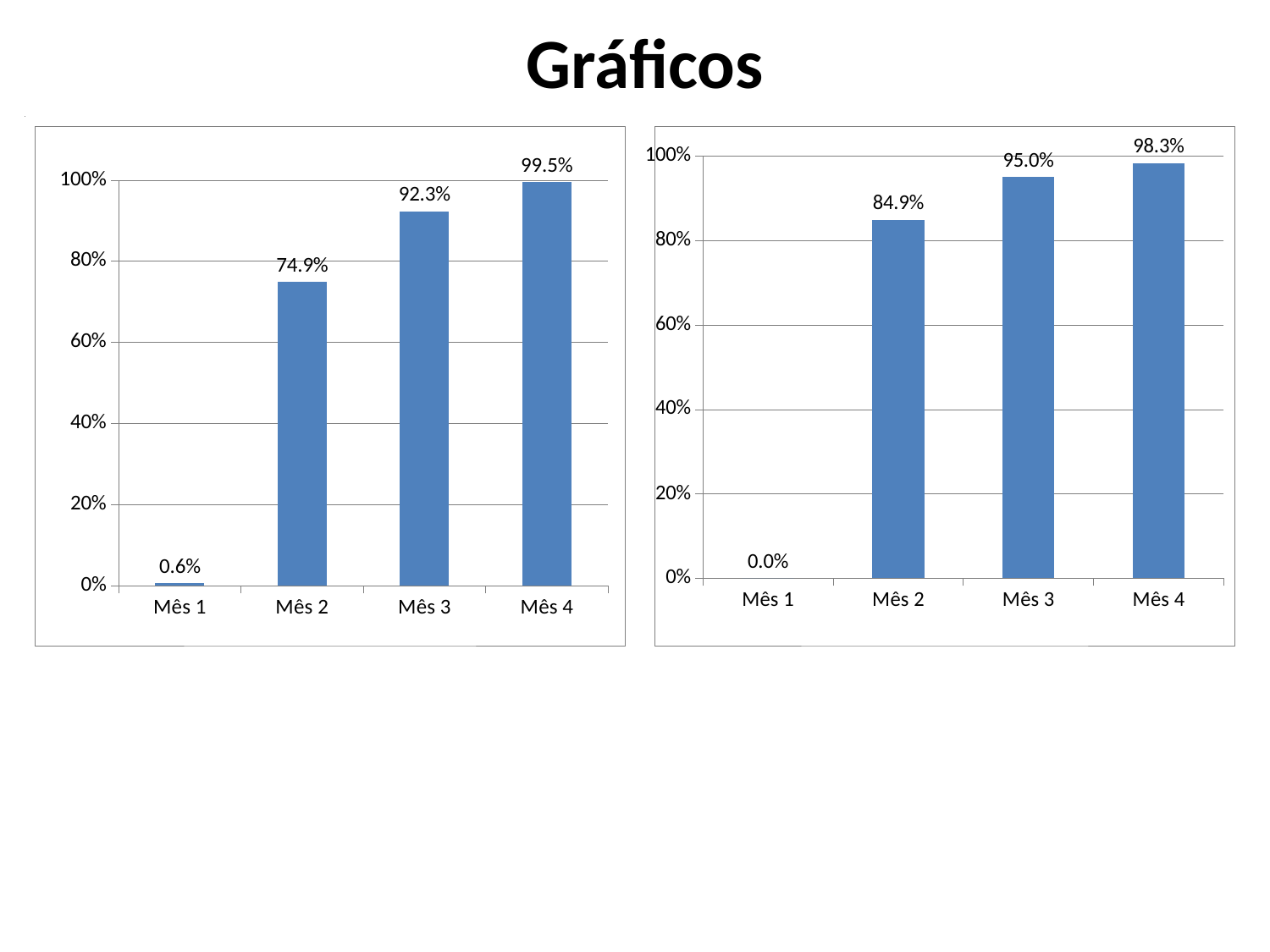
In the left chart, what is the value for Mês 2? 74.9% In the right chart, what is the difference between the values for Mês 3 and Mês 2? 10.1% What kind of chart is the left chart? bar chart In the right chart, what is the value for Mês 3? 95.0% In the left chart, what is the value for Mês 1? 0.6% How many categories are shown on the x axis of the right chart? 4 In the left chart, is the value for Mês 2 greater or less than 60%? greater In the left chart, which month has the lowest value? Mês 1 In the right chart, do the values rise or fall from Mês 1 to Mês 4? rise In the right chart, which month has the highest value? Mês 4 In the right chart, which is larger, the value for Mês 2 or the value for Mês 3? Mês 3 In the left chart, what is the difference between the values for Mês 4 and Mês 3? 7.2%